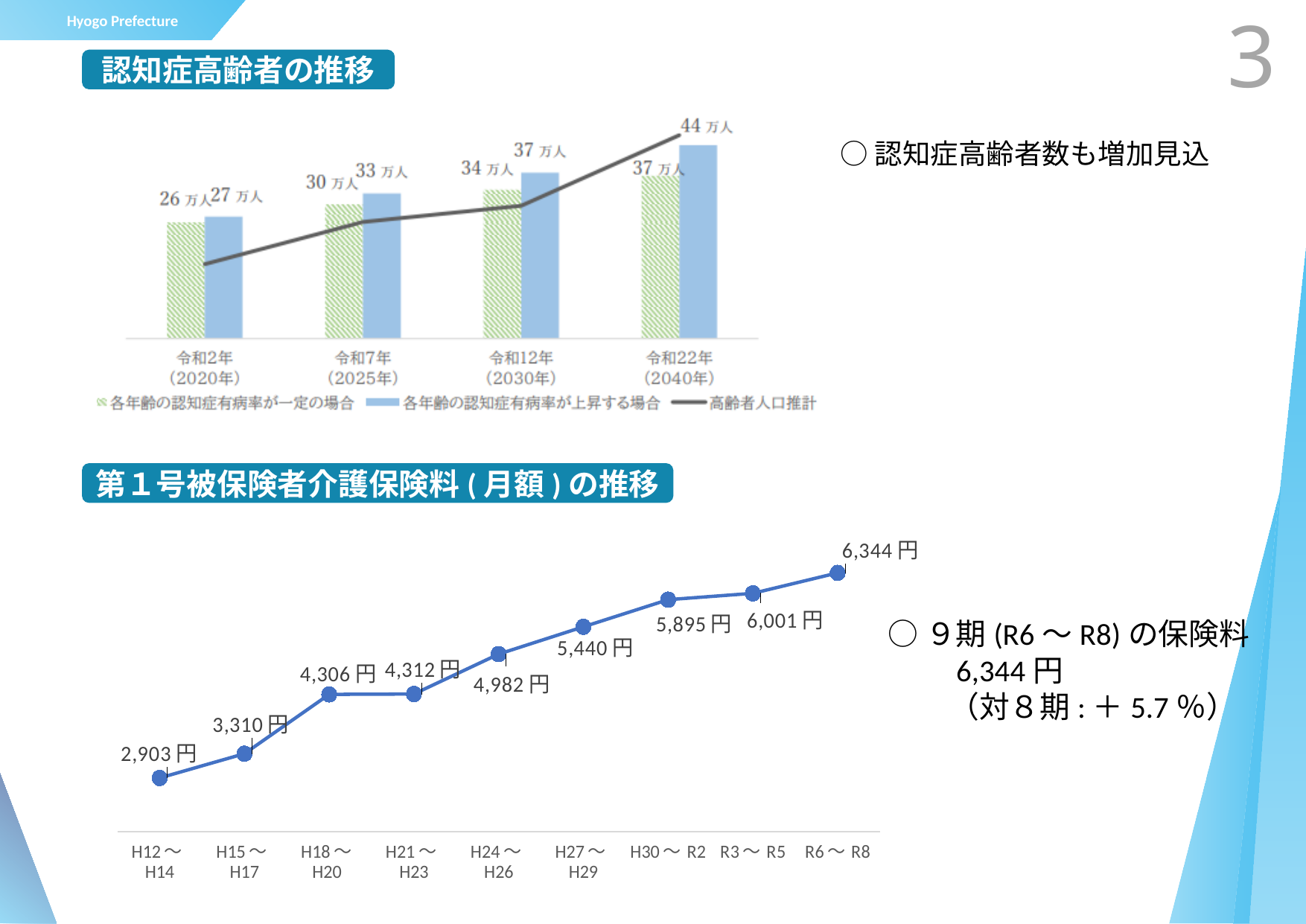
In the chart titled 認知症高齢者の推移, what is the value of 各年齢の認知症有病率が一定の場合 for 令和2年(2020年)? 26万人 In the chart titled 第１号被保険者介護保険料(月額)の推移, what is the difference between the values for R6〜R8 and R3〜R5? 343円 In the chart titled 第１号被保険者介護保険料(月額)の推移, do the values rise or fall from H12〜H14 to R6〜R8? rise In the chart titled 第１号被保険者介護保険料(月額)の推移, what is the value for H12〜H14? 2,903円 In the chart titled 認知症高齢者の推移, how many series does the legend list? 3 In the chart titled 認知症高齢者の推移, which is larger for 令和7年(2025年): 各年齢の認知症有病率が一定の場合 or 各年齢の認知症有病率が上昇する場合? 各年齢の認知症有病率が上昇する場合 In the chart titled 第１号被保険者介護保険料(月額)の推移, what is the value for H24〜H26? 4,982円 What kind of chart is the one titled 第１号被保険者介護保険料(月額)の推移? line chart In the chart titled 第１号被保険者介護保険料(月額)の推移, what is the value for R6〜R8? 6,344円 In the chart titled 第１号被保険者介護保険料(月額)の推移, which period has the lowest value? H12〜H14 In the chart titled 第１号被保険者介護保険料(月額)の推移, how many data points are plotted? 9 In the chart titled 認知症高齢者の推移, what is the value of 各年齢の認知症有病率が上昇する場合 for 令和12年(2030年)? 37万人